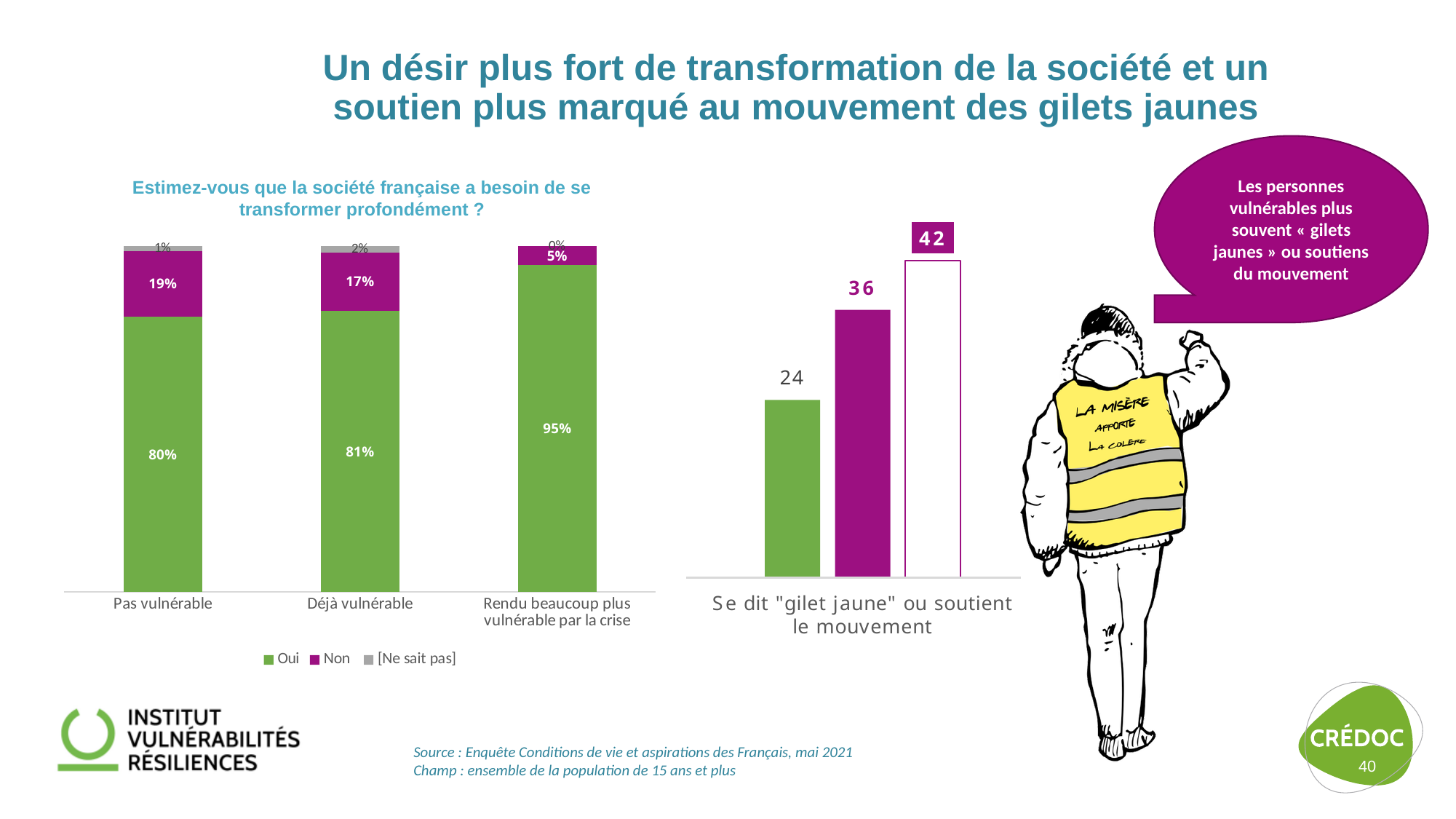
In the left chart, which category has the highest share of "Oui" answers? Rendu beaucoup plus vulnérable par la crise In the left chart, what percentage of the "Rendu beaucoup plus vulnérable par la crise" group answered "Oui"? 95% In the left chart, how many series does the legend list? 3 In the left chart, what colour represents the "Non" answers? Purple In the right chart, how many bars are plotted? 3 In the left chart, what percentage of the "Déjà vulnérable" group answered "Non"? 17% In the right chart, what is the difference between the white outlined bar and the purple bar? 6 In the left chart, which category has the lowest share of "Non" answers? Rendu beaucoup plus vulnérable par la crise In the right chart, what is the value of the tallest bar? 42 In the left chart, what is the difference in "Oui" answers between "Rendu beaucoup plus vulnérable par la crise" and "Pas vulnérable"? 15 percentage points In the left chart ("Estimez-vous que la société française a besoin de se transformer profondément ?"), what percentage of the "Pas vulnérable" group answered "Oui"? 80% In the right chart ("Se dit "gilet jaune" ou soutient le mouvement"), what is the value of the green bar? 24